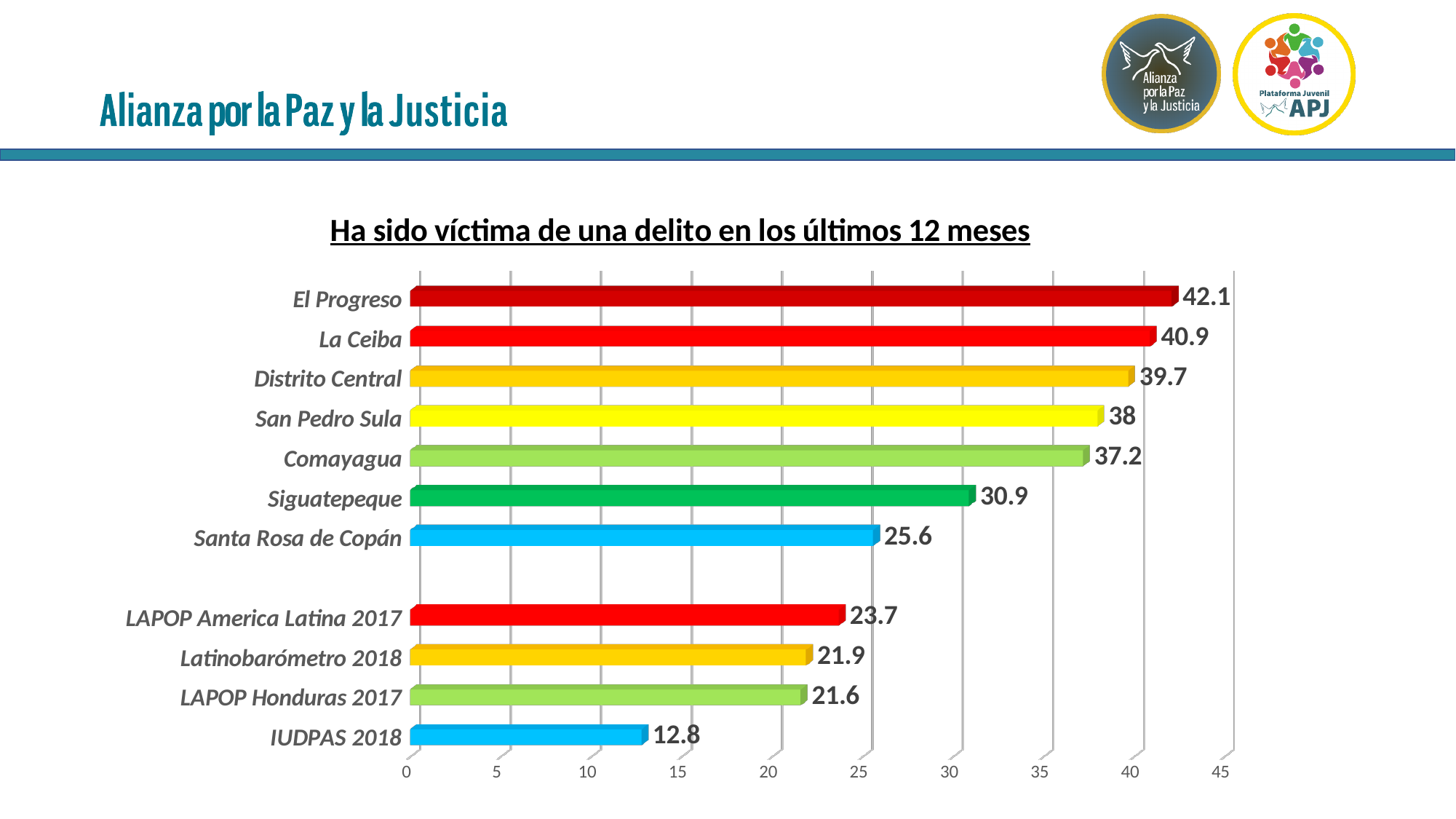
What kind of chart is shown on the slide? bar chart How many categories (bars) are shown in the chart? 11 Which category has the highest value? El Progreso What is the difference between the values for El Progreso and La Ceiba? 1.2 Which is larger, the value for Comayagua or the value for Siguatepeque? Comayagua What is the title of the chart? Ha sido víctima de una delito en los últimos 12 meses Is the value for San Pedro Sula greater or less than 35? greater Which category has the lowest value? IUDPAS 2018 What is the value for El Progreso? 42.1 What is the value for Santa Rosa de Copán? 25.6 What is the difference between the values for Siguatepeque and Santa Rosa de Copán? 5.3 What is the value for IUDPAS 2018? 12.8